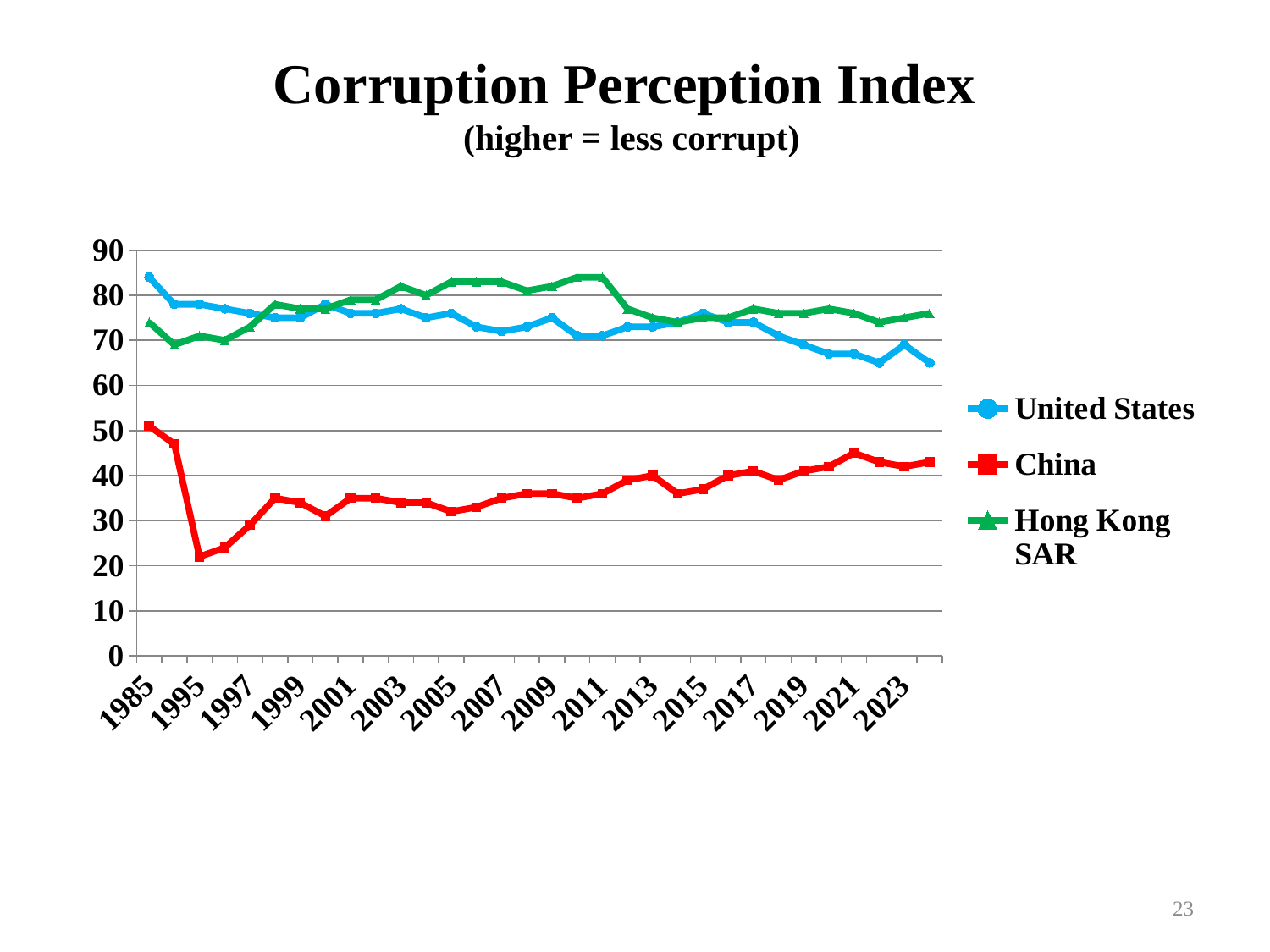
What kind of chart is shown on the slide? line chart Is the value for China in 1995 greater or less than 30? less Is the value for Hong Kong SAR in 2011 greater or less than 80? greater How many series does the legend list? 3 Does the United States line rise or fall overall from 1985 to 2023? fall What does the subtitle under the chart title say? (higher = less corrupt) Is the value for China in 2021 greater or less than 40? greater Which series is plotted in red? China In 2011, which is larger, the value for Hong Kong SAR or the value for the United States? Hong Kong SAR In 1985, which is larger, the value for the United States or the value for Hong Kong SAR? United States Which series has the lowest values across the whole period shown? China